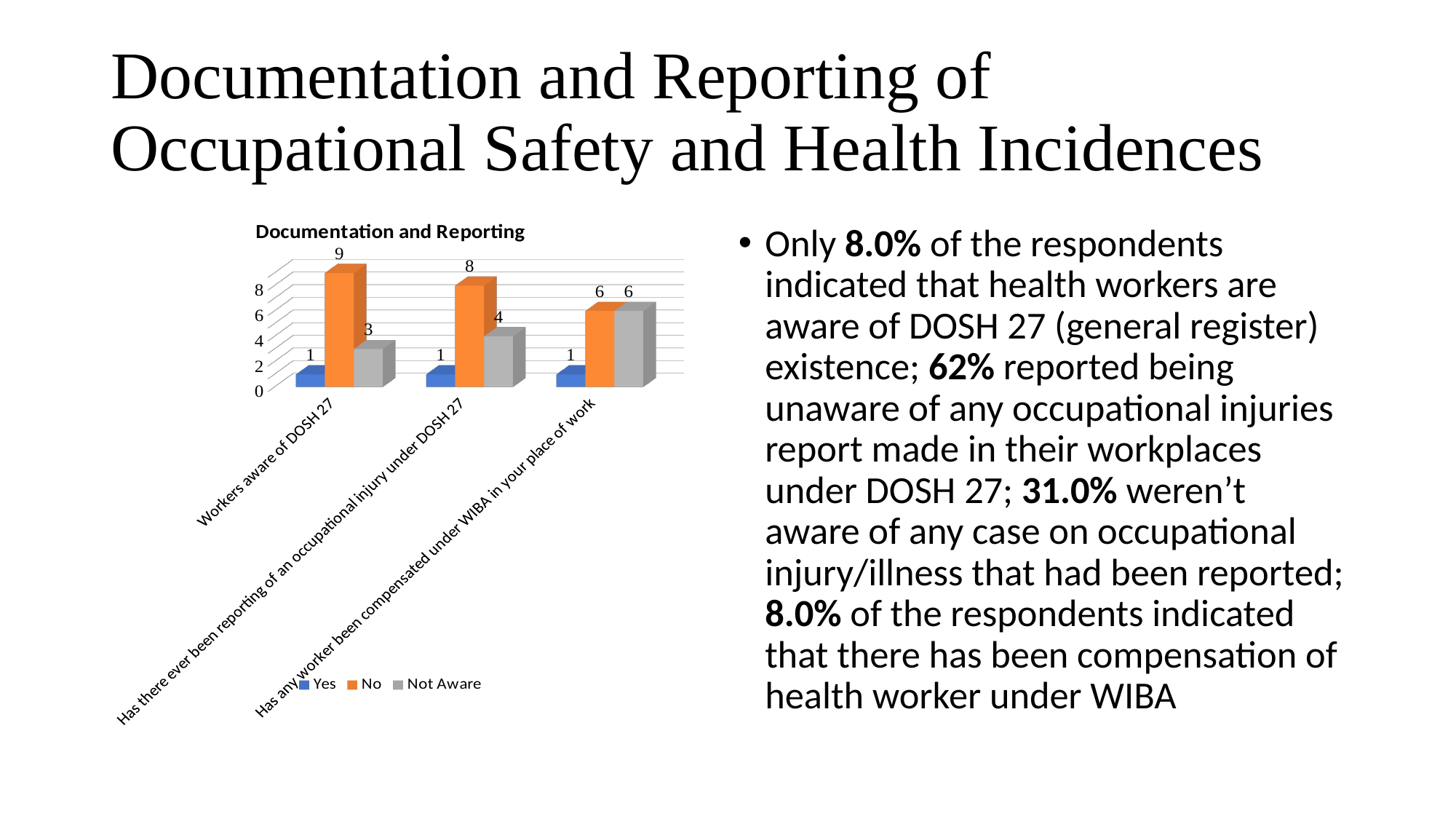
What is the difference between the No and Not Aware values in the category 'Workers aware of DOSH 27'? 6 What kind of chart is shown on the slide? bar chart What is the value for Not Aware in the category 'Has there ever been reporting of an occupational injury under DOSH 27'? 4 What is the title of the chart? Documentation and Reporting In the category 'Has there ever been reporting of an occupational injury under DOSH 27', which is larger, the No value or the Not Aware value? No How many categories are shown on the x axis of the chart? 3 Which category has the highest value for the No series? Workers aware of DOSH 27 How many series does the chart legend list? 3 What is the value for No in the category 'Workers aware of DOSH 27'? 9 What is the value for Yes in the category 'Has any worker been compensated under WIBA in your place of work'? 1 Which category has the lowest value for the Not Aware series? Workers aware of DOSH 27 Which series is shown in orange in the chart? No